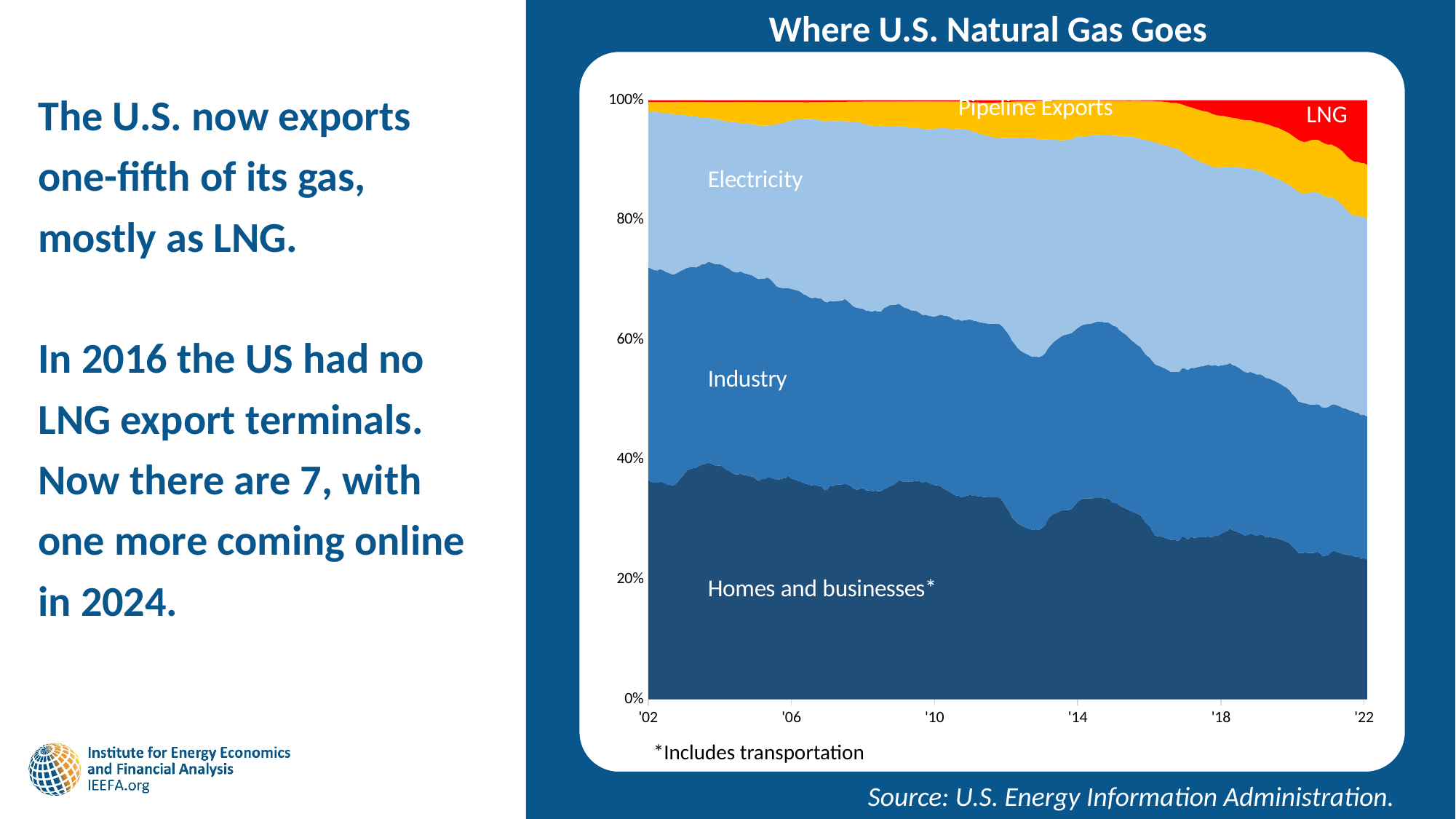
How many series (categories of gas use) are labelled in the chart? 5 Is the combined share of Homes and businesses and Industry in '02 greater or less than 60%? greater Does the share for Homes and businesses rise or fall from '02 to '22? Fall Is the share for Homes and businesses in '02 greater or less than 20%? greater Is the share for Homes and businesses in '22 greater or less than 40%? less What is the first year shown on the x axis? '02 What is the title of the chart? Where U.S. Natural Gas Goes What kind of chart is shown on the slide? Stacked area chart Does the share for Electricity rise or fall from '02 to '22? Rise Which series is shown in red at the top of the chart? LNG What is the last year shown on the x axis? '22